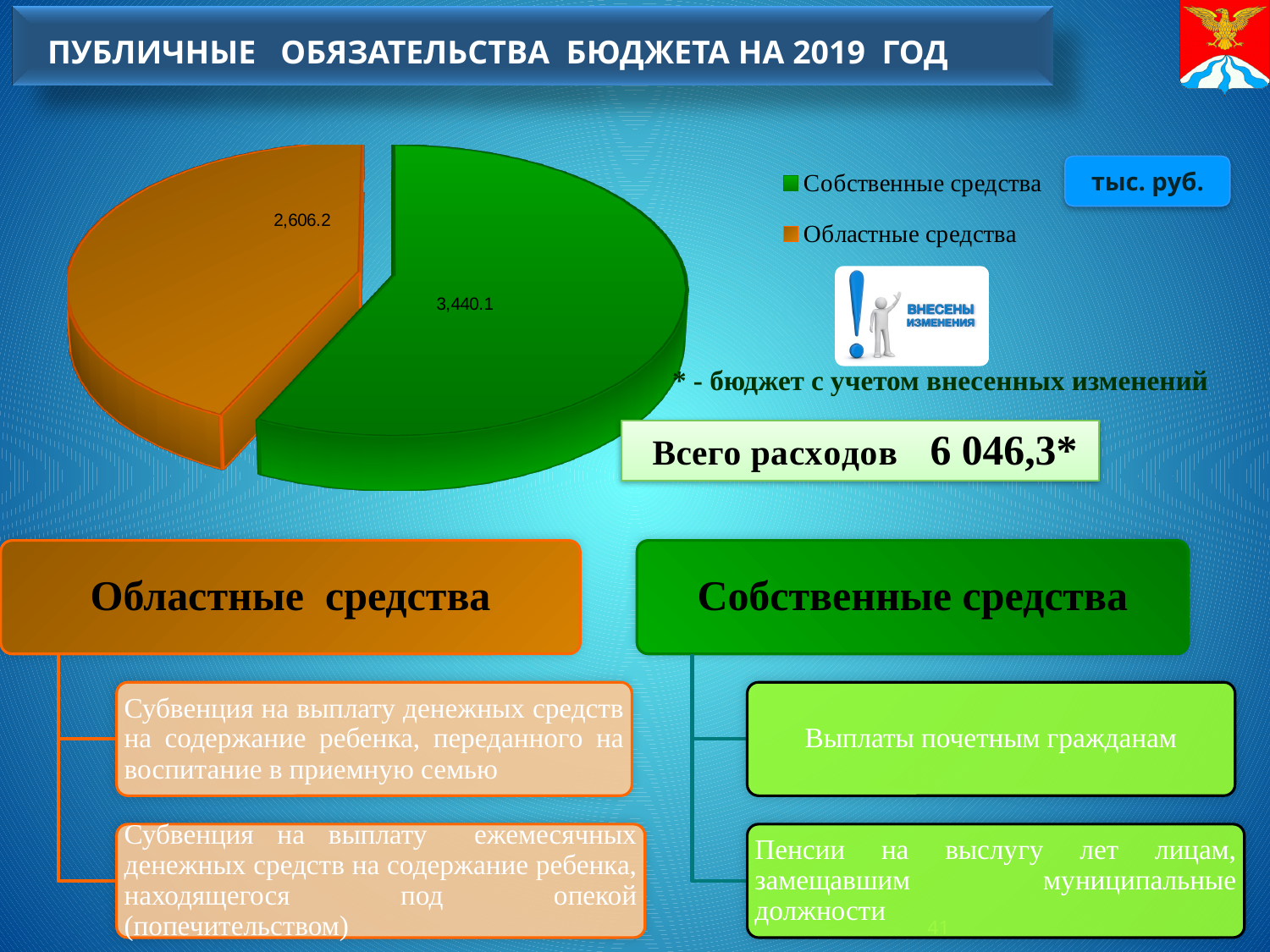
What is the value for Областные средства in the pie chart? 2,606.2 What colour is the Областные средства slice in the pie chart? orange What total expenditure (Всего расходов) is shown next to the pie chart? 6 046,3* What unit of measurement is indicated for the pie chart values? тыс. руб. Which slice of the pie chart is the smallest? Областные средства What type of chart is shown on the slide? pie chart What is the difference between Собственные средства and Областные средства in the pie chart? 833.9 Which slice of the pie chart is the largest? Собственные средства How many slices does the pie chart have? 2 Which is larger in the pie chart: Собственные средства or Областные средства? Собственные средства How many entries does the legend of the pie chart list? 2 What is the value for Собственные средства in the pie chart? 3,440.1